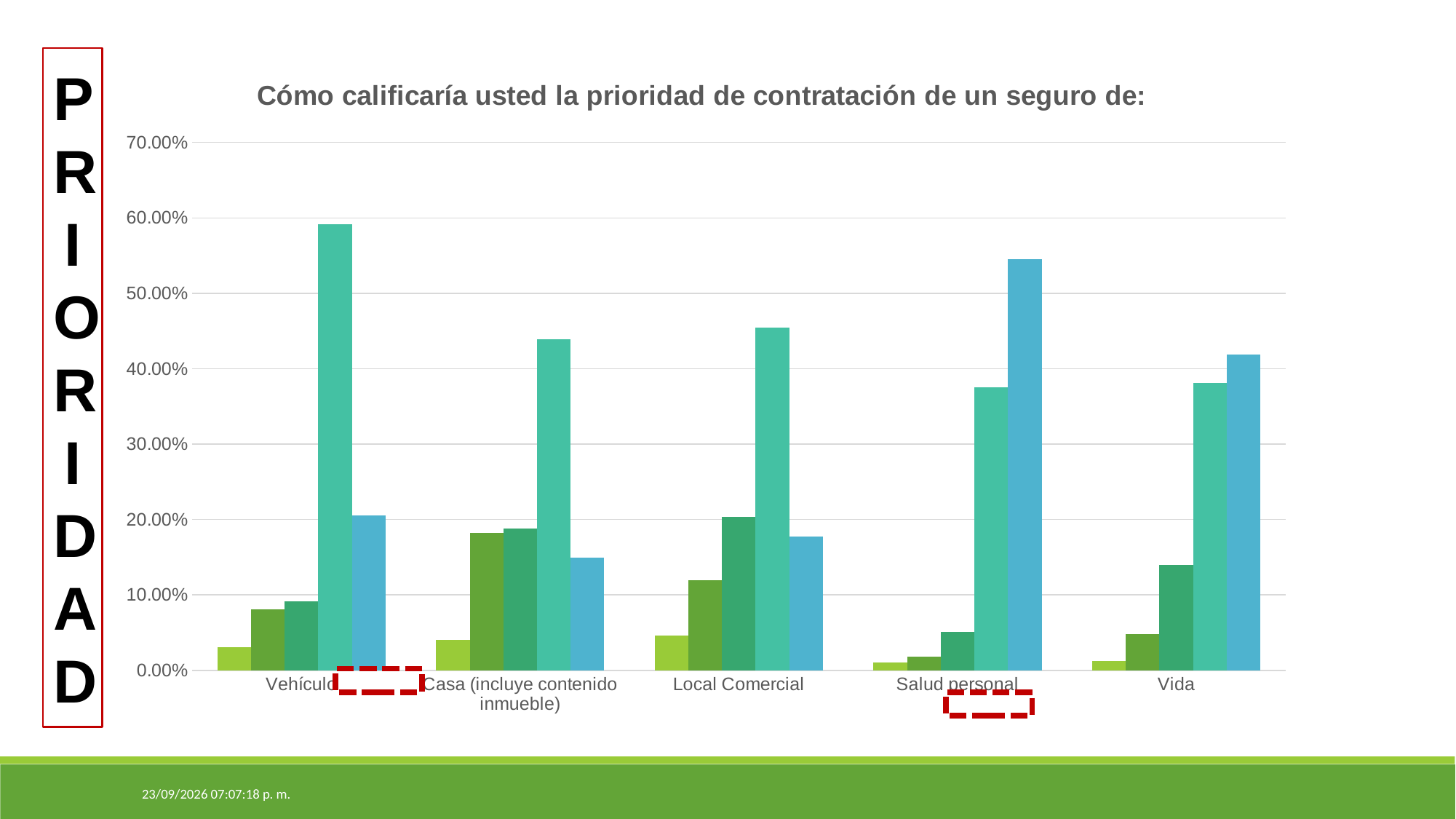
Which category has the tallest bar in the chart? Vehículo Is the teal bar for Casa (incluye contenido inmueble) greater or less than 50.00%? less What kind of chart is shown on the slide? bar chart What is the title of the chart? Cómo calificaría usted la prioridad de contratación de un seguro de: Is the light blue bar for Salud personal greater or less than 50.00%? greater How many categories are shown on the x axis of the chart? 5 Which category has the tallest light blue bar? Salud personal What is the highest value shown on the chart's vertical axis? 70.00% For Vida, which is larger: the teal bar or the light blue bar? the light blue bar How many bars are plotted for each category in the chart? 5 Is the light blue bar for Vehículo greater or less than 30.00%? less